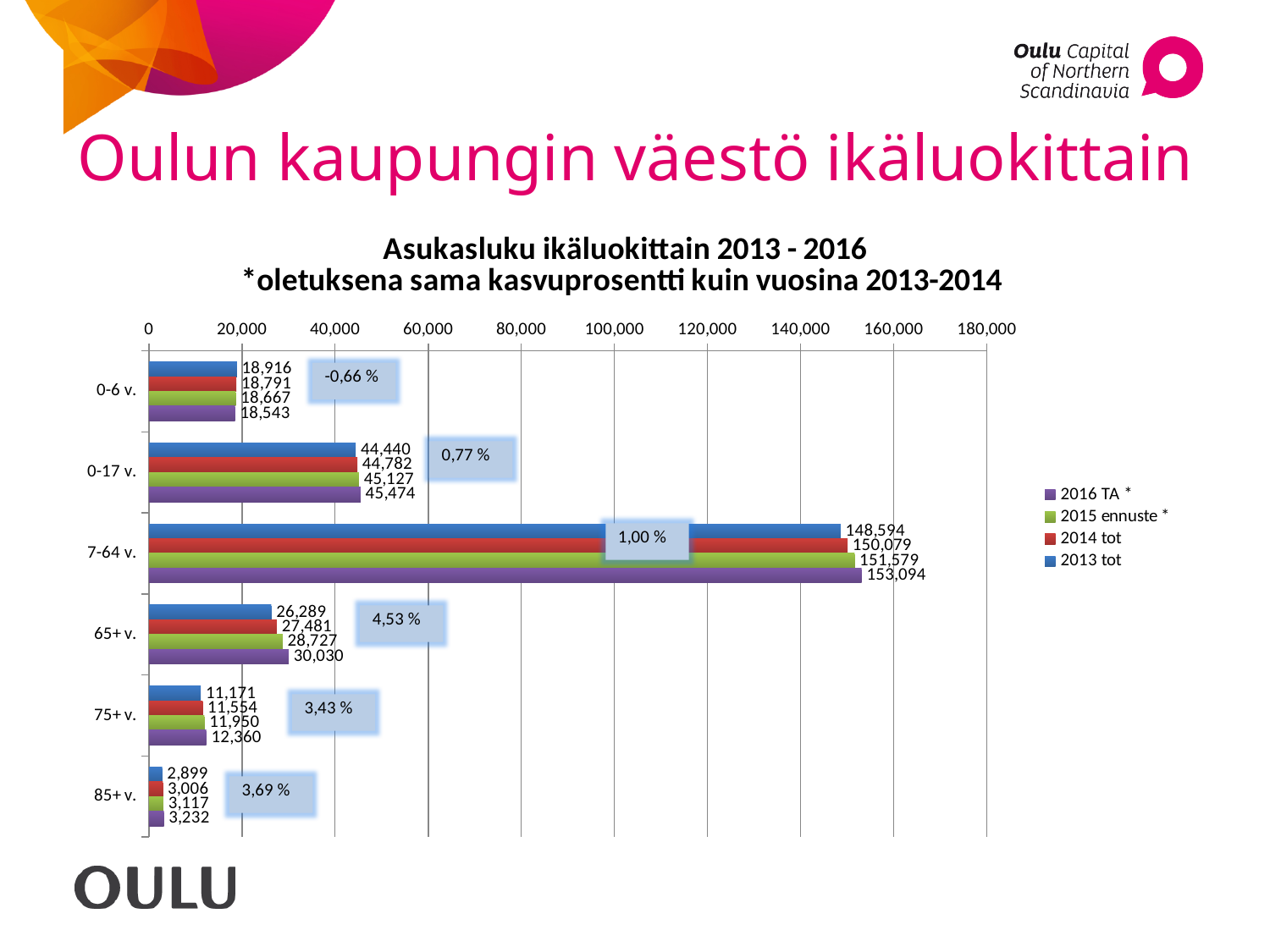
What is the 2016 TA * value for the 65+ v. age group? 30,030 What kind of chart is shown on the slide? Bar chart Which age group has the highest 2013 tot value? 7-64 v. How many series does the legend list? 4 What percentage is shown in the box next to the 65+ v. age group? 4,53 % What is the 2013 tot value for the 7-64 v. age group? 148,594 What is the difference between the 2016 TA * and 2013 tot values for the 75+ v. age group? 1,189 What is the 2014 tot value for the 85+ v. age group? 3,006 How many age groups are shown on the chart? 6 Which age group has the lowest 2016 TA * value? 85+ v. What is the 2015 ennuste * value for the 0-17 v. age group? 45,127 For the 0-6 v. age group, which is larger: the 2013 tot value or the 2016 TA * value? 2013 tot